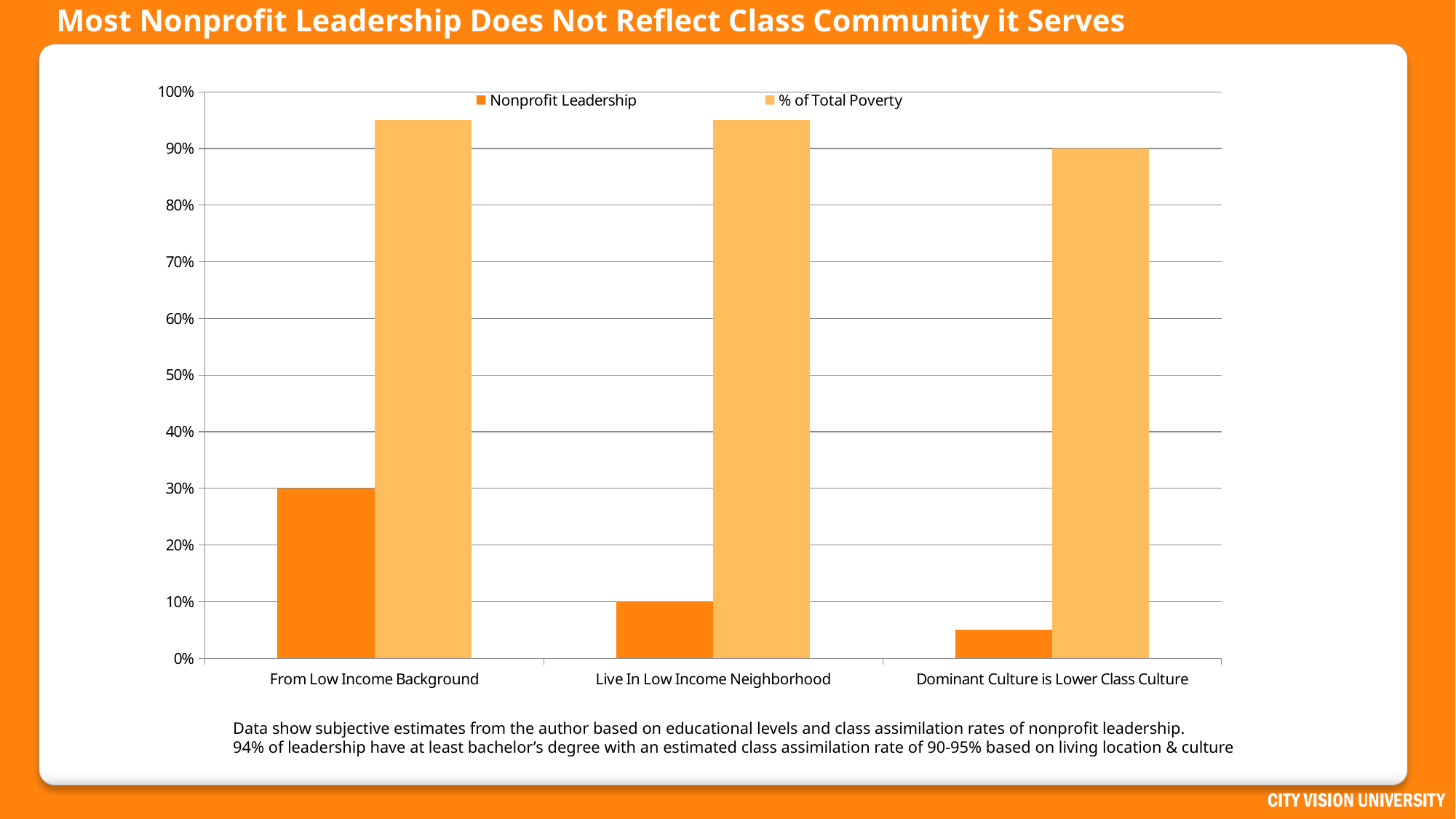
Which category has the lowest % of Total Poverty value? Dominant Culture is Lower Class Culture How many series does the legend list? 2 Is the % of Total Poverty value for From Low Income Background greater or less than 90%? greater What is the Nonprofit Leadership value for Live In Low Income Neighborhood? 10% What is the difference between the Nonprofit Leadership values for From Low Income Background and Live In Low Income Neighborhood? 20% Which category has the highest Nonprofit Leadership value? From Low Income Background How many categories are shown on the x axis? 3 Is the Nonprofit Leadership value for Dominant Culture is Lower Class Culture greater or less than 10%? less For Live In Low Income Neighborhood, which series has the larger value: Nonprofit Leadership or % of Total Poverty? % of Total Poverty What type of chart is shown on the slide? bar chart What is the Nonprofit Leadership value for From Low Income Background? 30% What is the % of Total Poverty value for Dominant Culture is Lower Class Culture? 90%